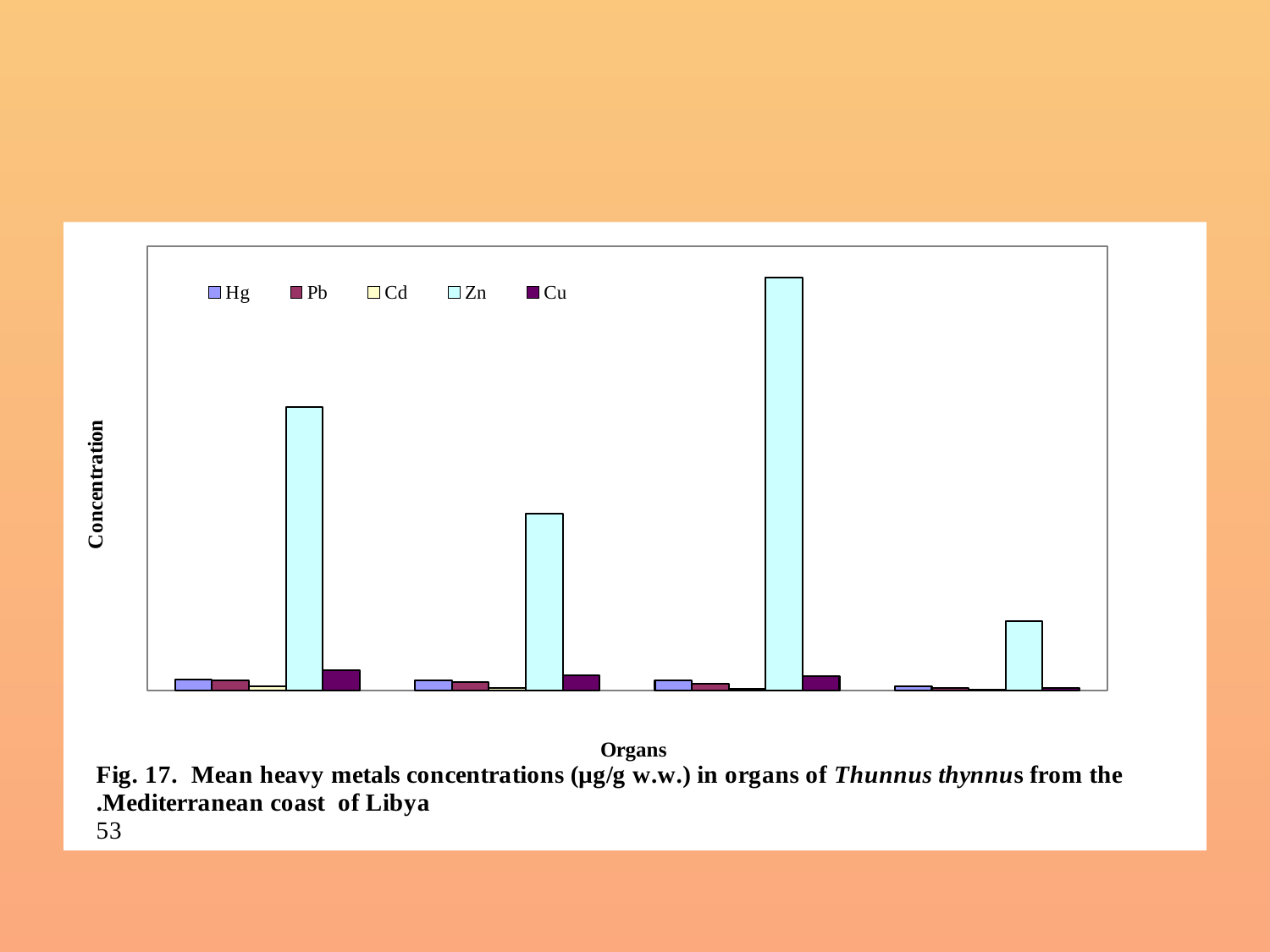
In the first group of bars from the left, which series has the lowest value? Cd In which group of bars, counting from the left, is the Zn bar the shortest? fourth What is the label of the y axis? Concentration What is the label of the x axis? Organs Which series has the tallest bar in every group? Zn In the first group of bars from the left, which is larger, Zn or Cu? Zn What kind of chart is shown on the slide? bar chart In which group of bars, counting from the left, is the Zn bar the tallest? third How many groups of bars (organs) are plotted on the x axis? 4 Which series are listed in the legend? Hg, Pb, Cd, Zn, Cu How many series does the legend list? 5 Is the Zn bar in the second group from the left taller or shorter than the Zn bar in the first group? shorter